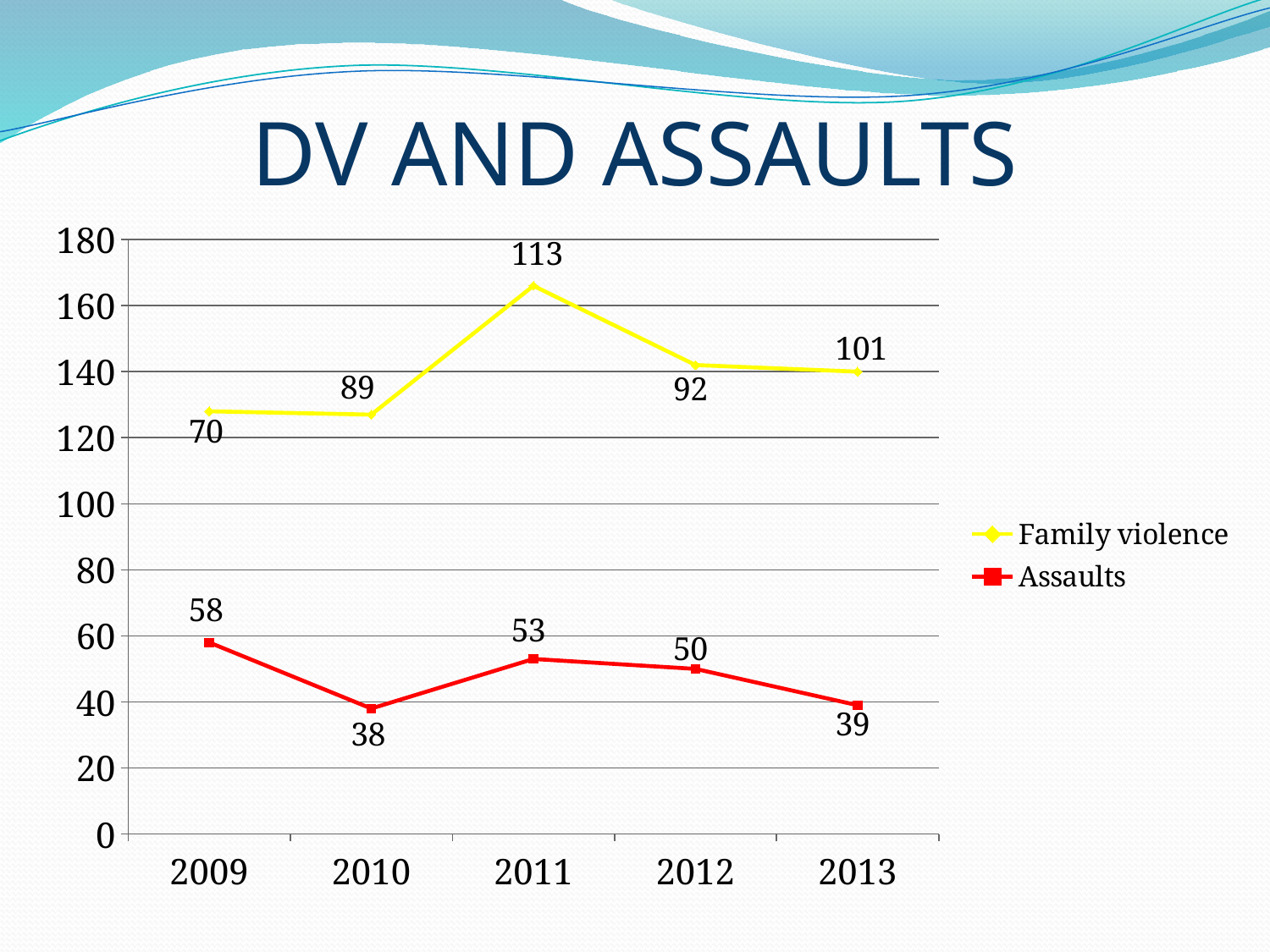
What is the Family violence value for 2013? 101 In which year is the Assaults value lowest? 2010 What is the Assaults value for 2010? 38 What is the Assaults value for 2009? 58 How many series does the legend list? 2 What is the title of the slide? DV AND ASSAULTS What kind of chart is shown on the slide? Line chart What is the Family violence value for 2011? 113 How many years are shown on the x axis? 5 Which is larger, the Assaults value for 2012 or for 2013? 2012 What is the difference between the Family violence values for 2011 and 2010? 24 In which year is the Family violence value highest? 2011